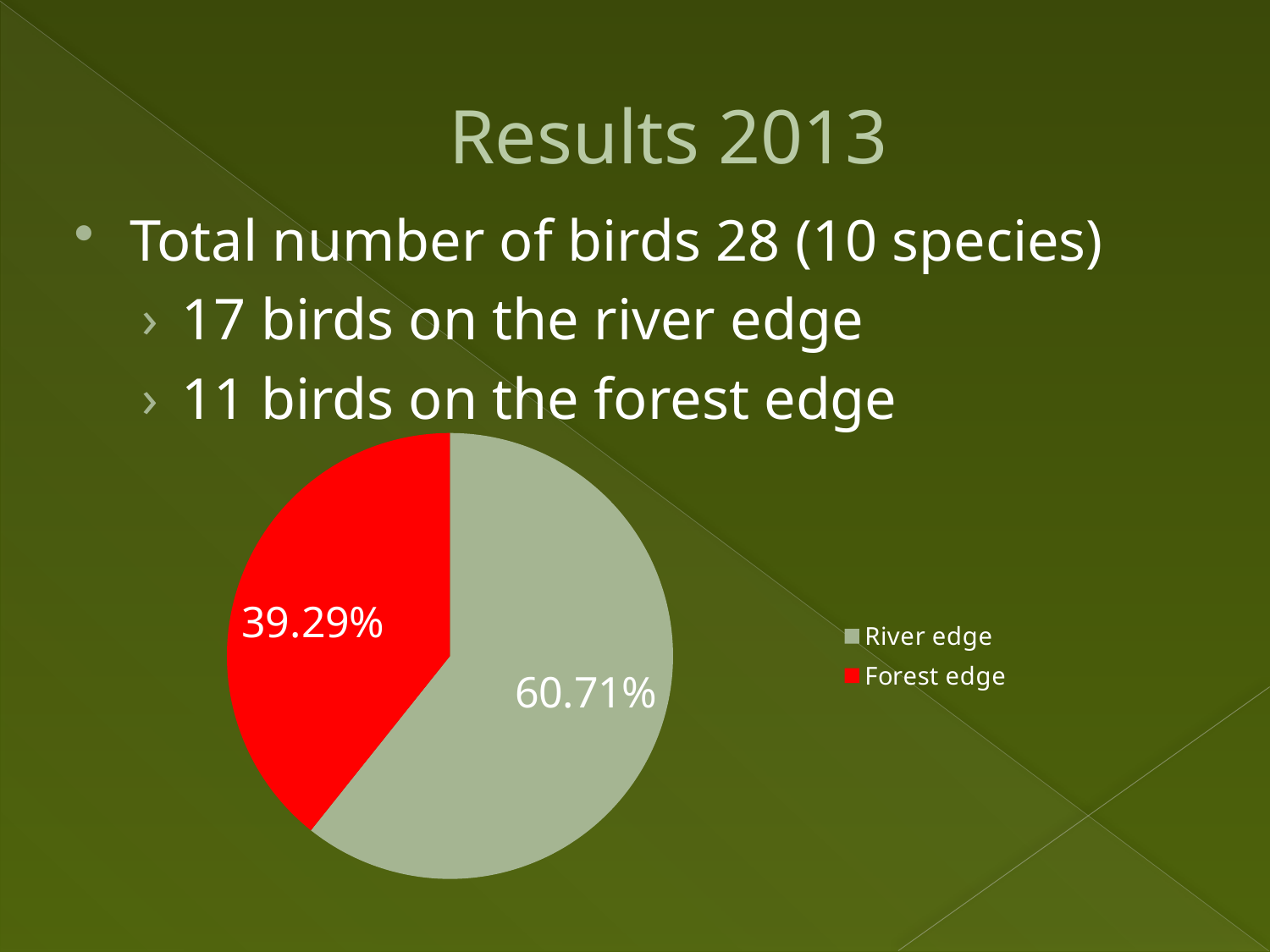
How many slices does the pie chart have? 2 What colour is the Forest edge slice? red Which slice of the pie is the smallest? Forest edge What share of the pie does Forest edge represent? 39.29% How many entries does the legend list? 2 Is the share for Forest edge greater or less than 50%? less Which slice of the pie is the largest? River edge What is the difference in percentage points between the River edge and Forest edge slices? 21.42 What kind of chart is shown on the slide? pie chart Which is larger, the River edge slice or the Forest edge slice? River edge Which legend entry is shown in grey-green? River edge What share of the pie does River edge represent? 60.71%